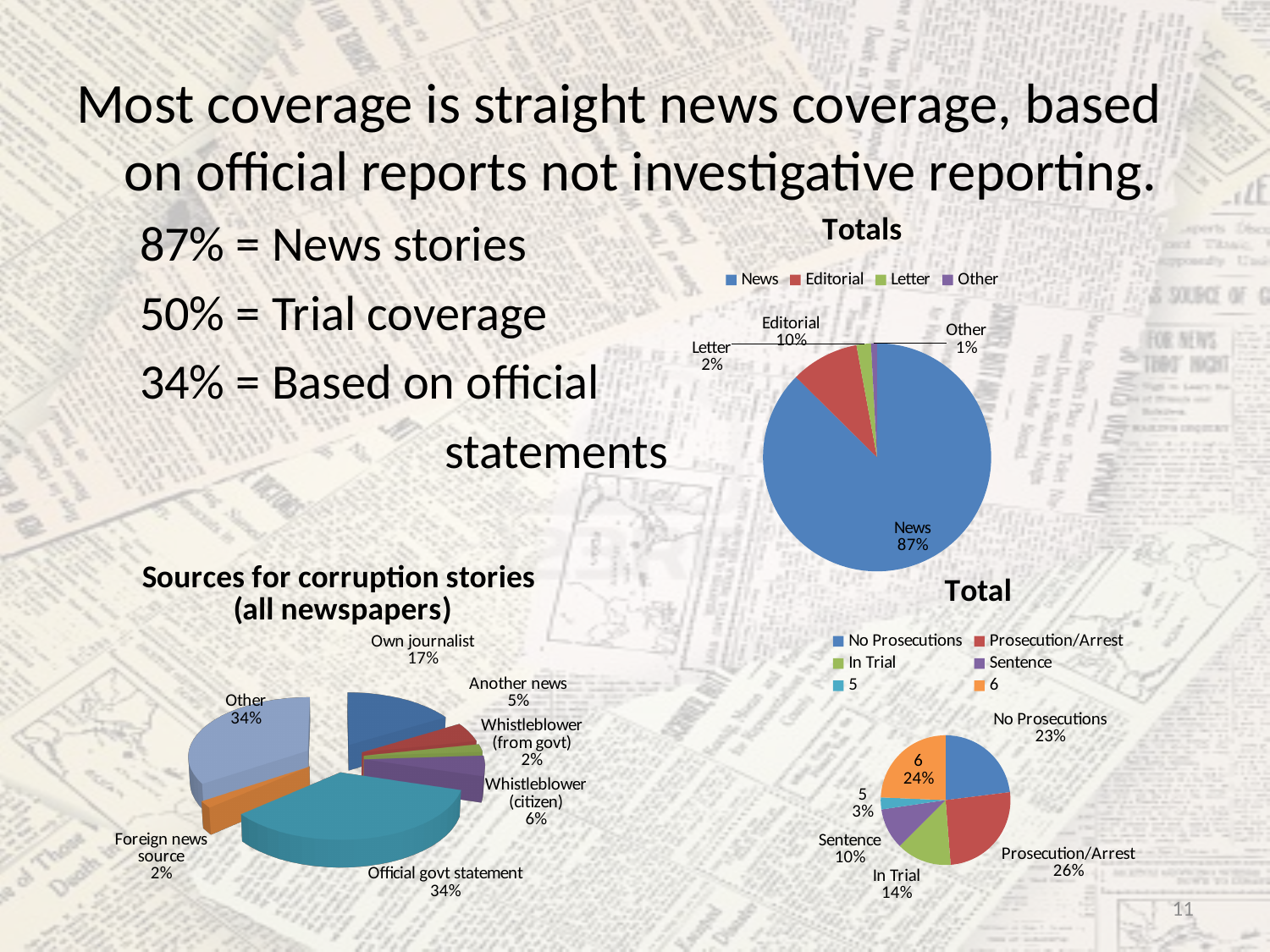
In the "Sources for corruption stories (all newspapers)" chart, what share is Official govt statement? 34% In the "Sources for corruption stories (all newspapers)" chart, what is the difference between Own journalist and Another news? 12% In the "Sources for corruption stories (all newspapers)" chart, what share is Own journalist? 17% In the "Total" pie chart, what share is Prosecution/Arrest? 26% In the "Totals" pie chart, what share is Editorial? 10% What type of chart is the "Total" chart? Pie chart In the "Total" pie chart, which is larger, In Trial or Sentence? In Trial In the "Sources for corruption stories (all newspapers)" chart, how many slices are there? 7 How many entries does the legend of the "Totals" pie chart list? 4 In the "Totals" pie chart, what share is News? 87% In the "Totals" pie chart, which category has the smallest share? Other In the "Total" pie chart, which category has the largest share? Prosecution/Arrest